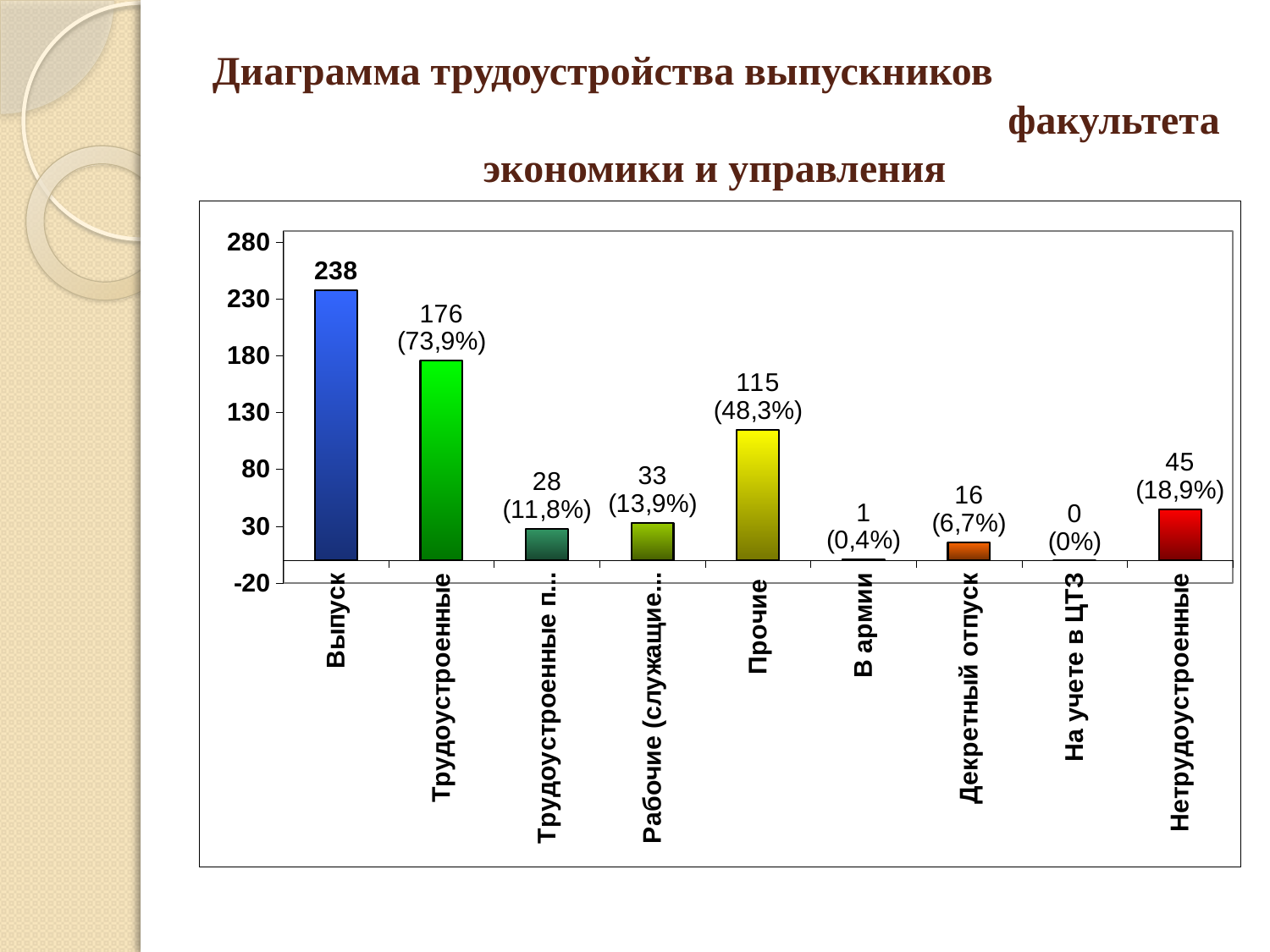
Which category has the highest value? Выпуск What is the value for Декретный отпуск? 16 What kind of chart is shown on the slide? bar chart What is the value for Нетрудоустроенные? 45 How many categories are plotted on the chart? 9 What percentage is shown for Прочие? 48,3% What percentage is shown for В армии? 0,4% What is the difference between the values for Выпуск and Трудоустроенные? 62 What is the value for Трудоустроенные? 176 Which is larger, the value for Прочие or the value for Нетрудоустроенные? Прочие What is the value for Выпуск? 238 Which category has the lowest value? На учете в ЦТЗ